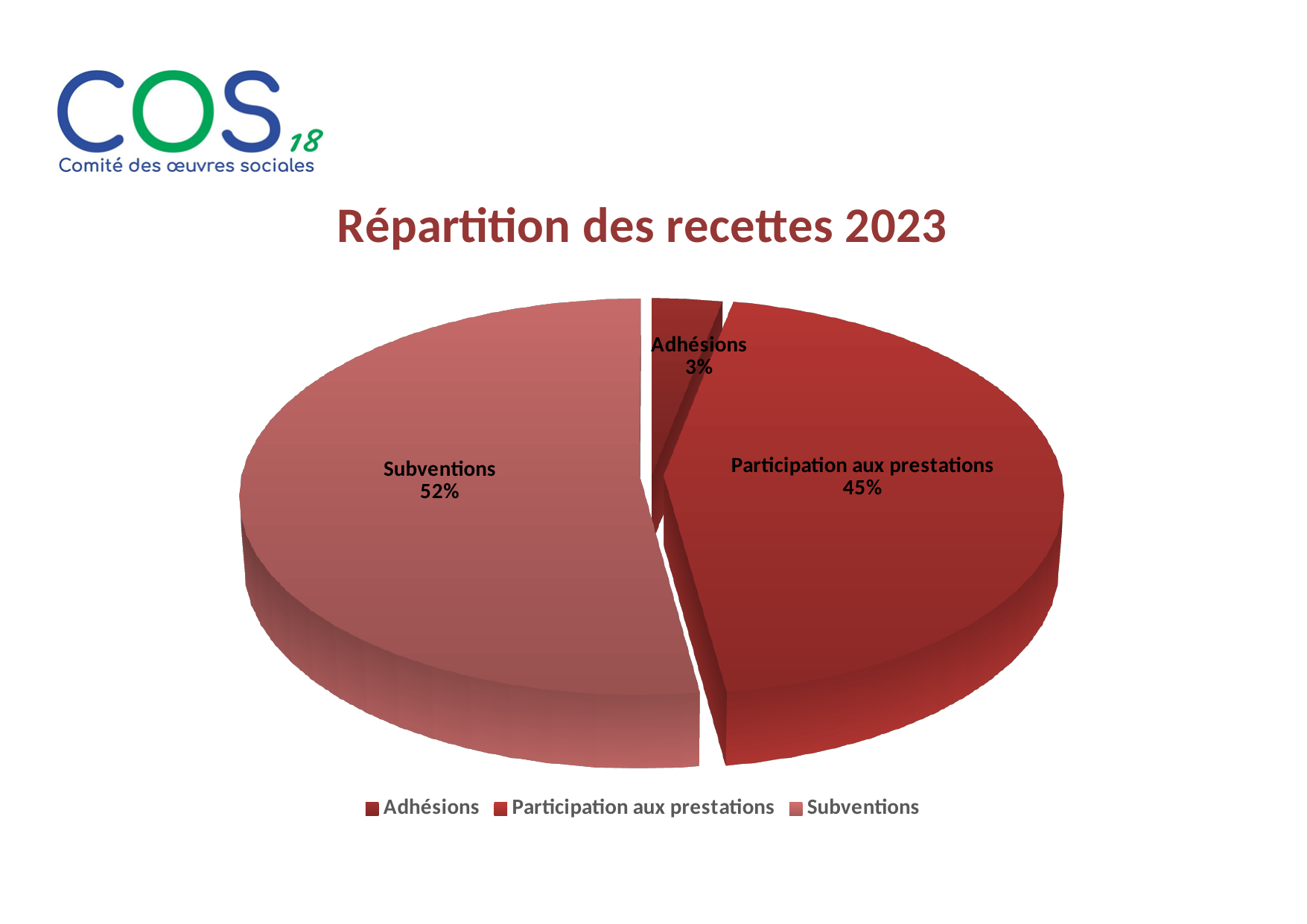
What is the title of the chart? Répartition des recettes 2023 What share of the pie does Adhésions represent? 3% Which category has the smallest share of the pie? Adhésions What is the difference in percentage points between Participation aux prestations and Adhésions? 42 How many entries does the legend list? 3 What is the difference in percentage points between Subventions and Participation aux prestations? 7 What kind of chart is shown on the slide? Pie chart What share of the pie does Participation aux prestations represent? 45% Which is larger, the share for Subventions or the share for Participation aux prestations? Subventions How many slices does the pie chart have? 3 Which category has the largest share of the pie? Subventions What share of the pie does Subventions represent? 52%